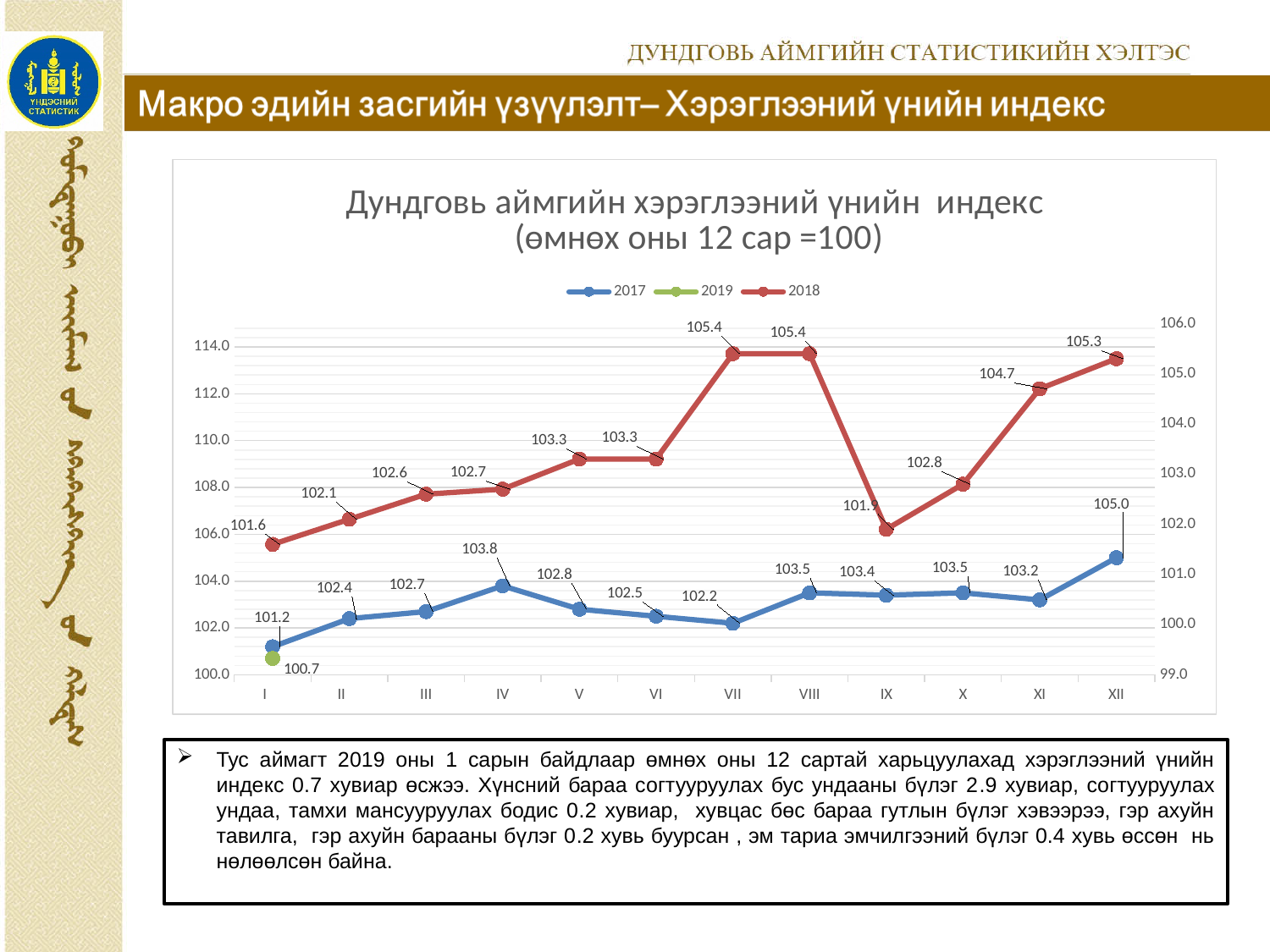
What is the value of the 2019 series in month I? 100.7 Does the 2017 series rise or fall from month IX to month XII? rise What type of chart is shown on the slide? line chart Which is larger: the 2017 value in month XII or the 2017 value in month XI? 2017 value in month XII How many series does the legend list? 3 In which month is the 2018 series at its lowest value? I Which series is drawn in red? 2018 What is the difference between the 2018 values in month VIII and month IX? 3.5 What is the value of the 2017 series in month IV? 103.8 What is the value of the 2018 series in month IX? 101.9 In which month does the 2017 series reach its highest value? XII How many months (categories) are shown on the x axis? 12